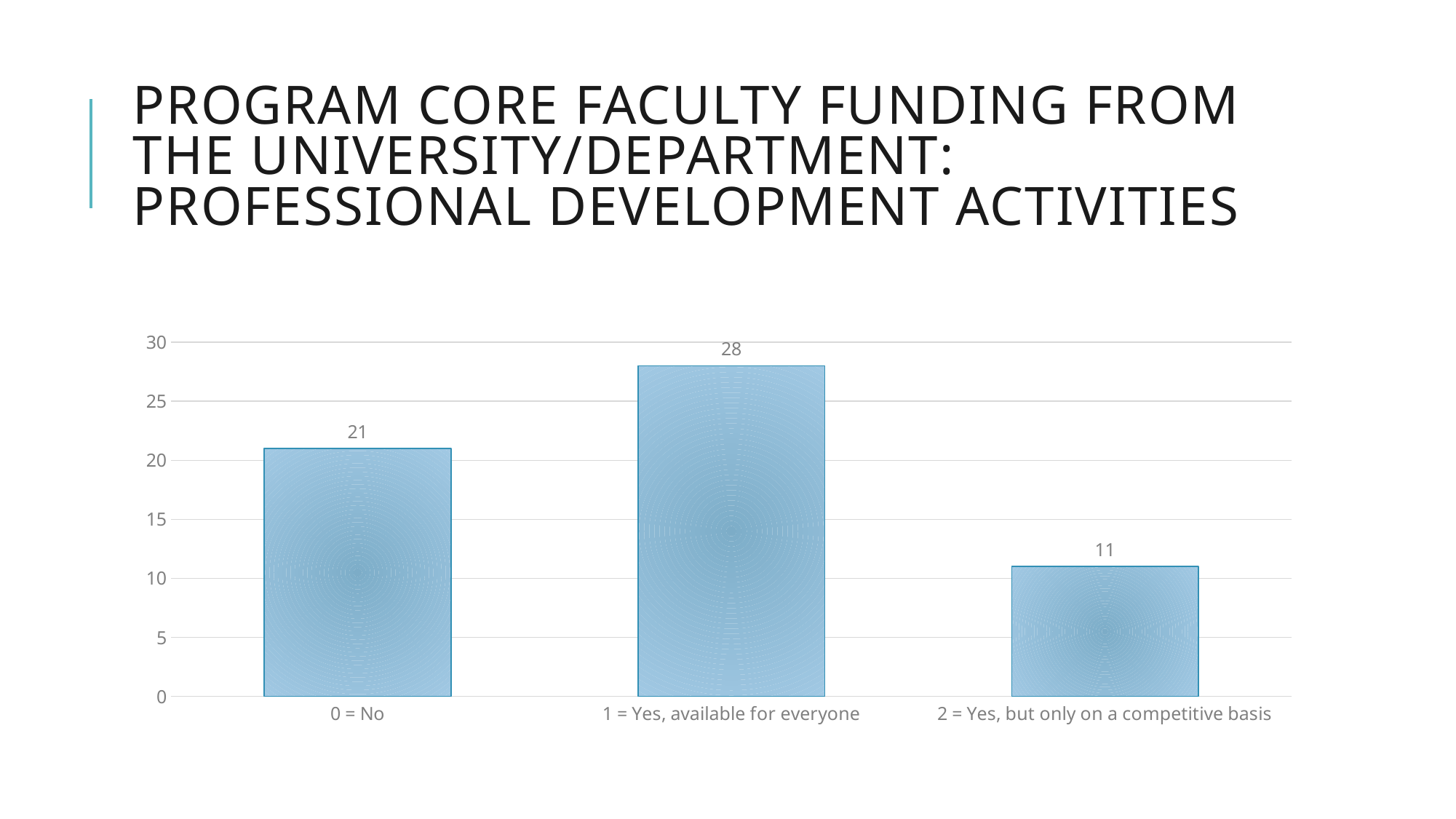
What is the difference between the values for "0 = No" and "2 = Yes, but only on a competitive basis"? 10 What kind of chart is shown on the slide? bar chart Which category has the lowest value? 2 = Yes, but only on a competitive basis Is the value for "1 = Yes, available for everyone" greater or less than 25? greater What is the total of the three bar values? 60 What is the value for "1 = Yes, available for everyone"? 28 What is the difference between the values for "1 = Yes, available for everyone" and "0 = No"? 7 How many categories are shown on the x axis? 3 What is the value for "0 = No"? 21 Which category has the highest value? 1 = Yes, available for everyone Which is larger, the value for "0 = No" or the value for "2 = Yes, but only on a competitive basis"? 0 = No What is the value for "2 = Yes, but only on a competitive basis"? 11